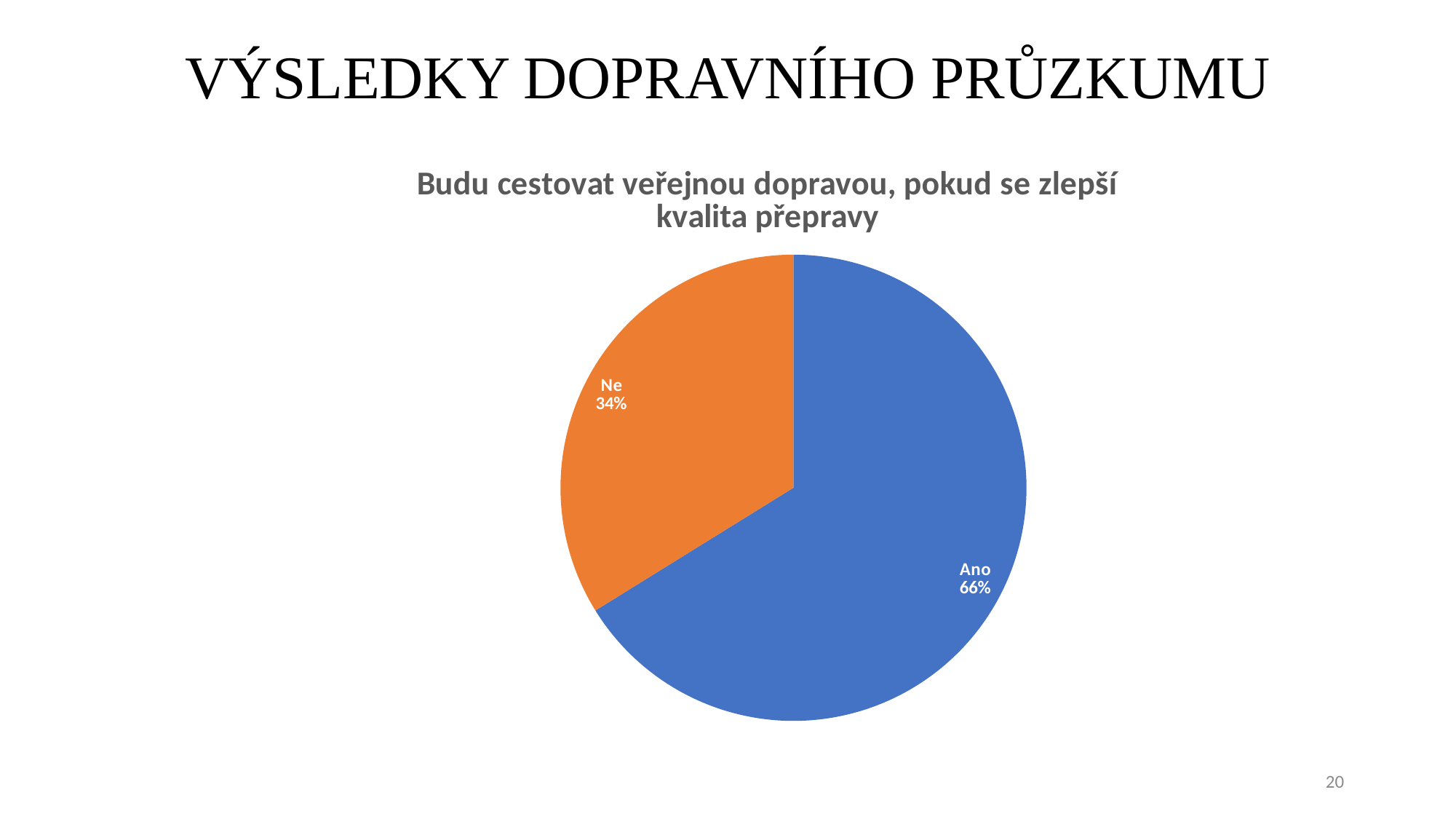
What kind of chart is shown on the slide? Pie chart Is the share of the "Ano" slice greater or less than 50%? greater How many slices does the pie chart have? 2 What colour is the "Ne" slice? Orange Which slice is the smallest in the pie chart? Ne What is the title of the chart? Budu cestovat veřejnou dopravou, pokud se zlepší kvalita přepravy What share of the pie does the "Ano" slice represent? 66% Which slice is larger, "Ano" or "Ne"? Ano What share of the pie does the "Ne" slice represent? 34% Which slice is the largest in the pie chart? Ano What is the difference in percentage points between the "Ano" and "Ne" slices? 32